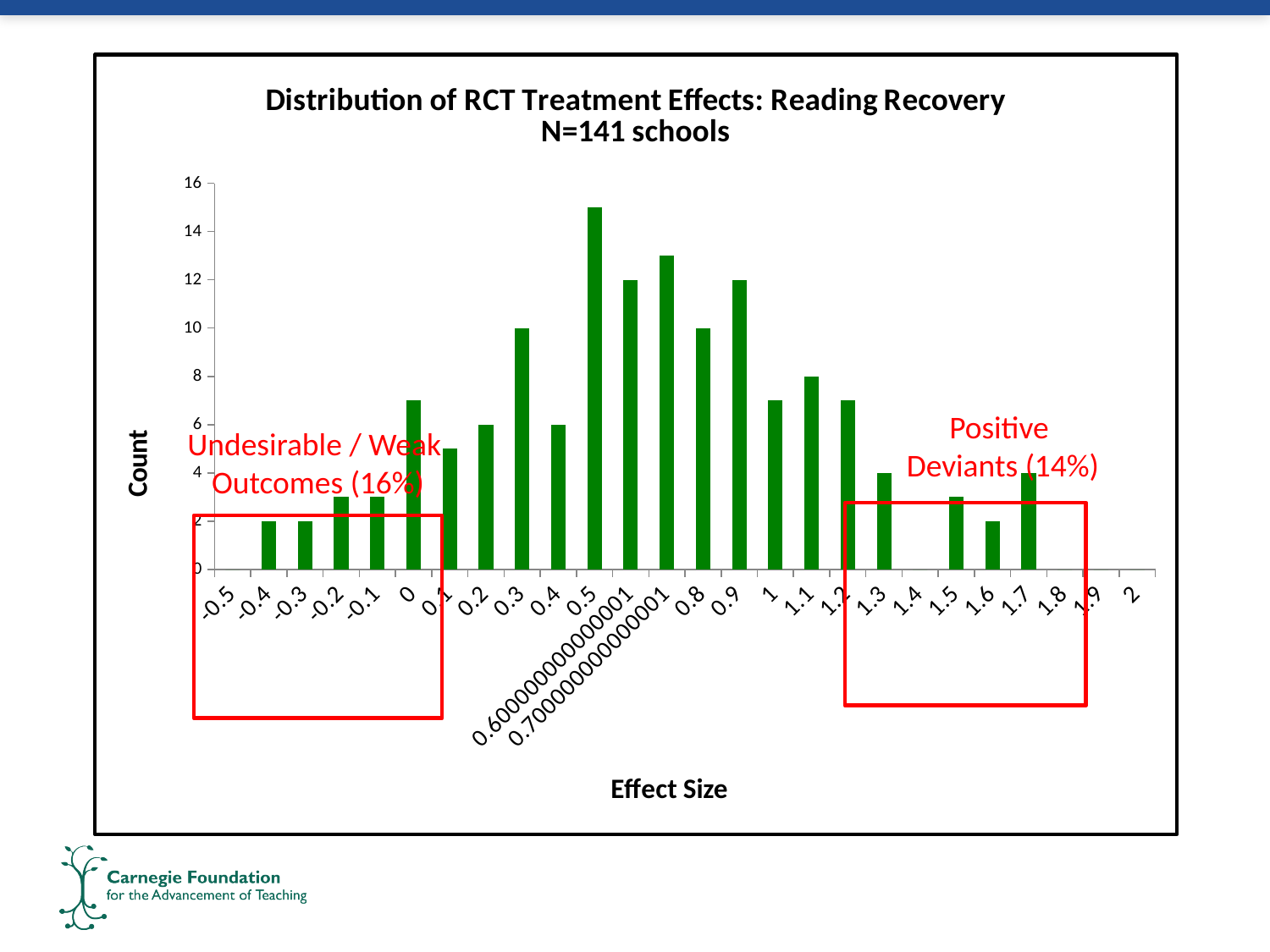
What is the count for effect size 0.3? 10 What percentage is labelled as Positive Deviants on the chart? 14% Is the count for effect size 1.2 greater or less than 8? less Which has a higher count, effect size 0.5 or effect size 0.7? 0.5 How many effect size labels are shown on the x axis? 26 Is the count for effect size 1.5 greater or less than 4? less Which effect size has the highest count? 0.5 What type of chart is shown on the slide? Bar chart Is the count for effect size 0.7 greater or less than 12? greater Which has a higher count, effect size 0.3 or effect size 0.4? 0.3 How many schools does the chart title say are included? 141